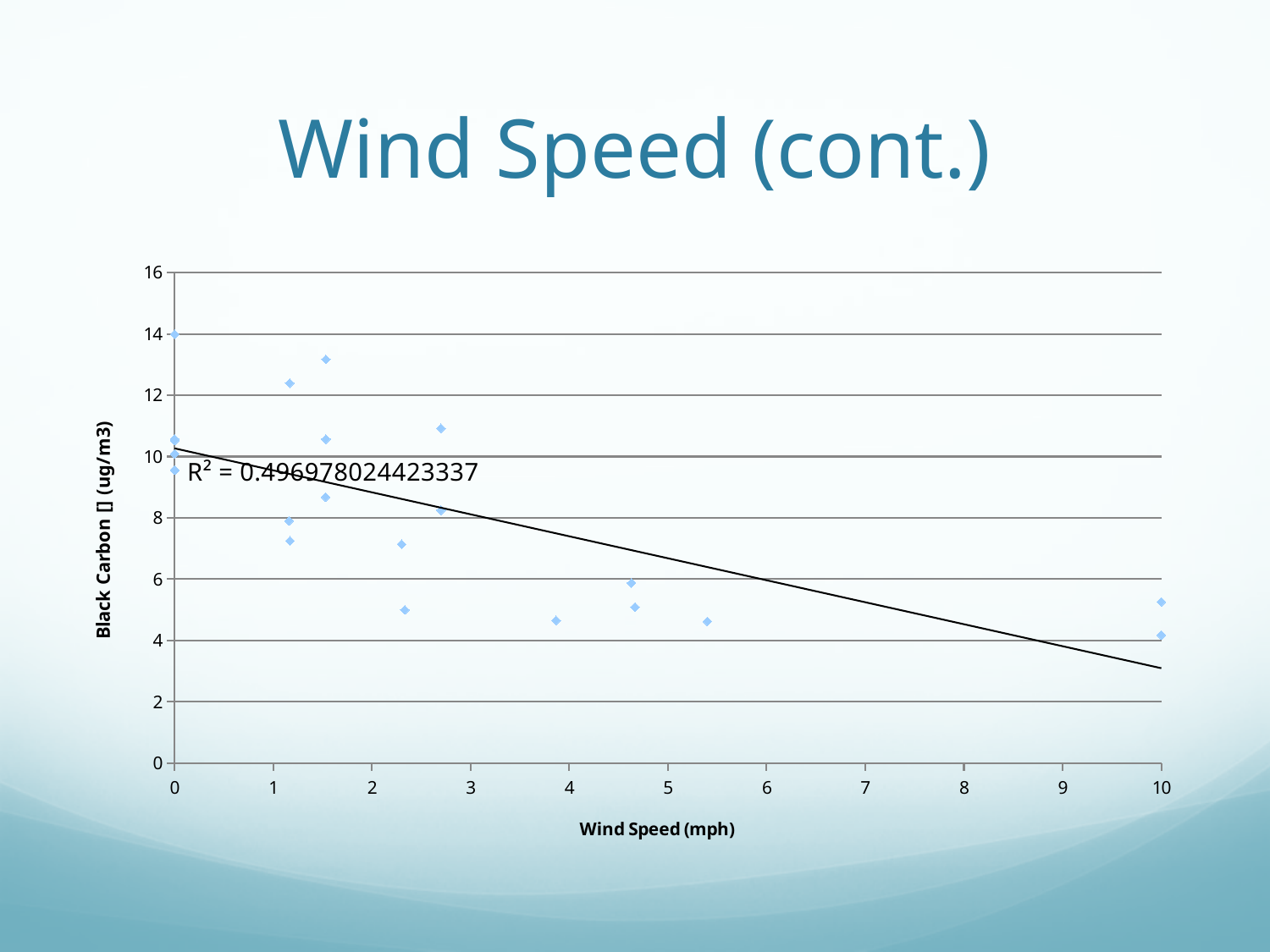
Is the highest data point at wind speed 0 mph greater or less than 12 ug/m3? greater Does black carbon concentration generally rise or fall as wind speed increases along the x axis? fall Are the data points at wind speed 10 mph greater or less than 6 ug/m3? less Is the trendline value at wind speed 0 mph greater or less than 8 ug/m3? greater What is the label of the x axis? Wind Speed (mph) What kind of chart is shown on the slide? scatter chart How many data points are plotted at wind speed 10 mph? 2 What R² value is printed on the chart? R² = 0.496978024423337 What is the maximum value shown on the y axis? 16